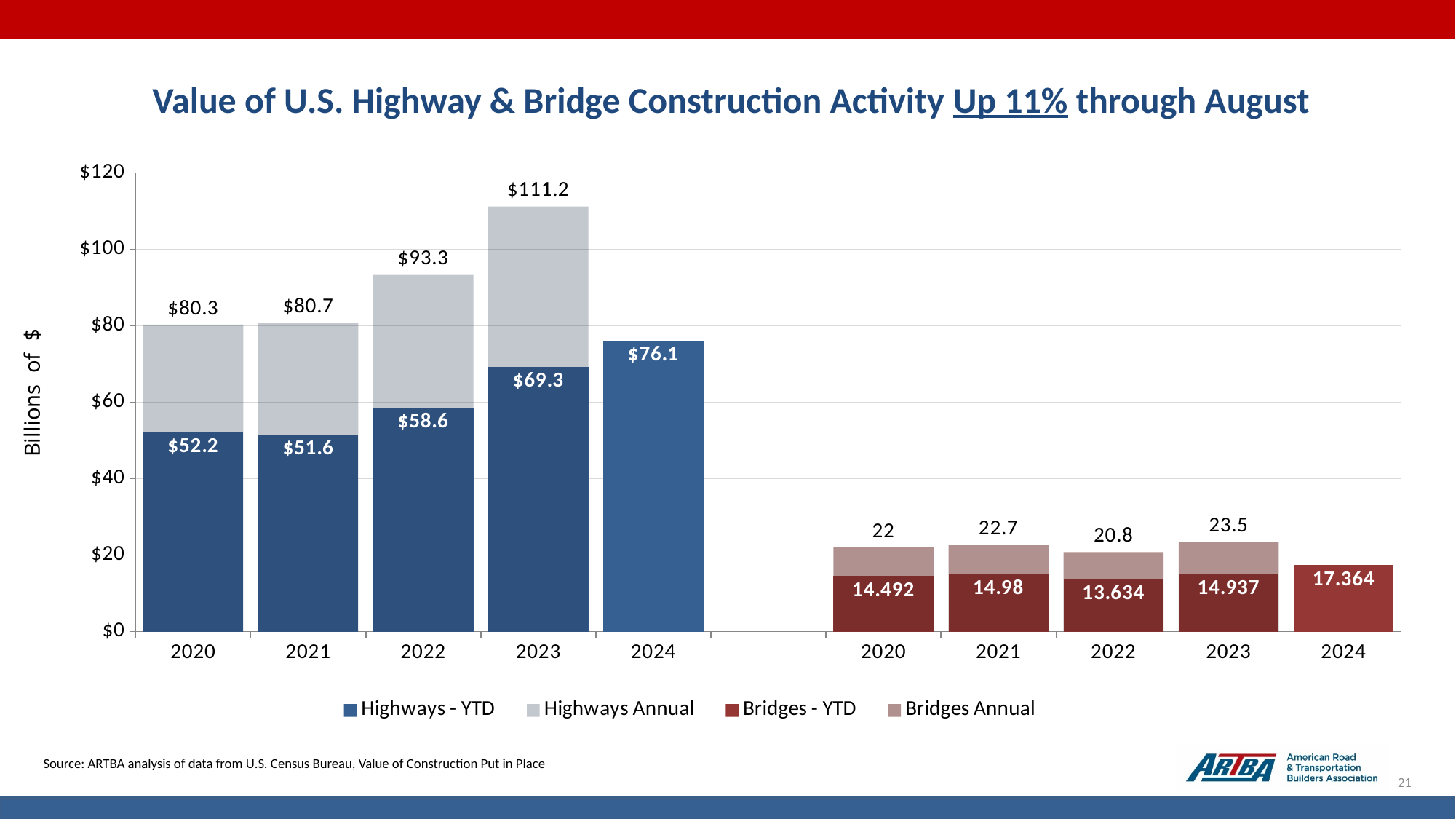
What is the difference between the Bridges - YTD values for 2024 and 2023? 2.427 What is the Bridges - YTD value for 2022? 13.634 Which year has the lowest Bridges - YTD value? 2022 Which year has the highest Highways - YTD value? 2024 Is the total annual highway value for 2022 greater or less than $100? less What is the Highways - YTD value for 2024? $76.1 What is the difference between the Highways - YTD values for 2024 and 2023? $6.8 How many series does the legend list? 4 Which is larger, the Highways - YTD value for 2020 or for 2021? 2020 What is the total annual bridge construction value shown for 2021? 22.7 What is the total annual highway construction value shown for 2023? $111.2 What kind of chart is shown on the slide? Bar chart